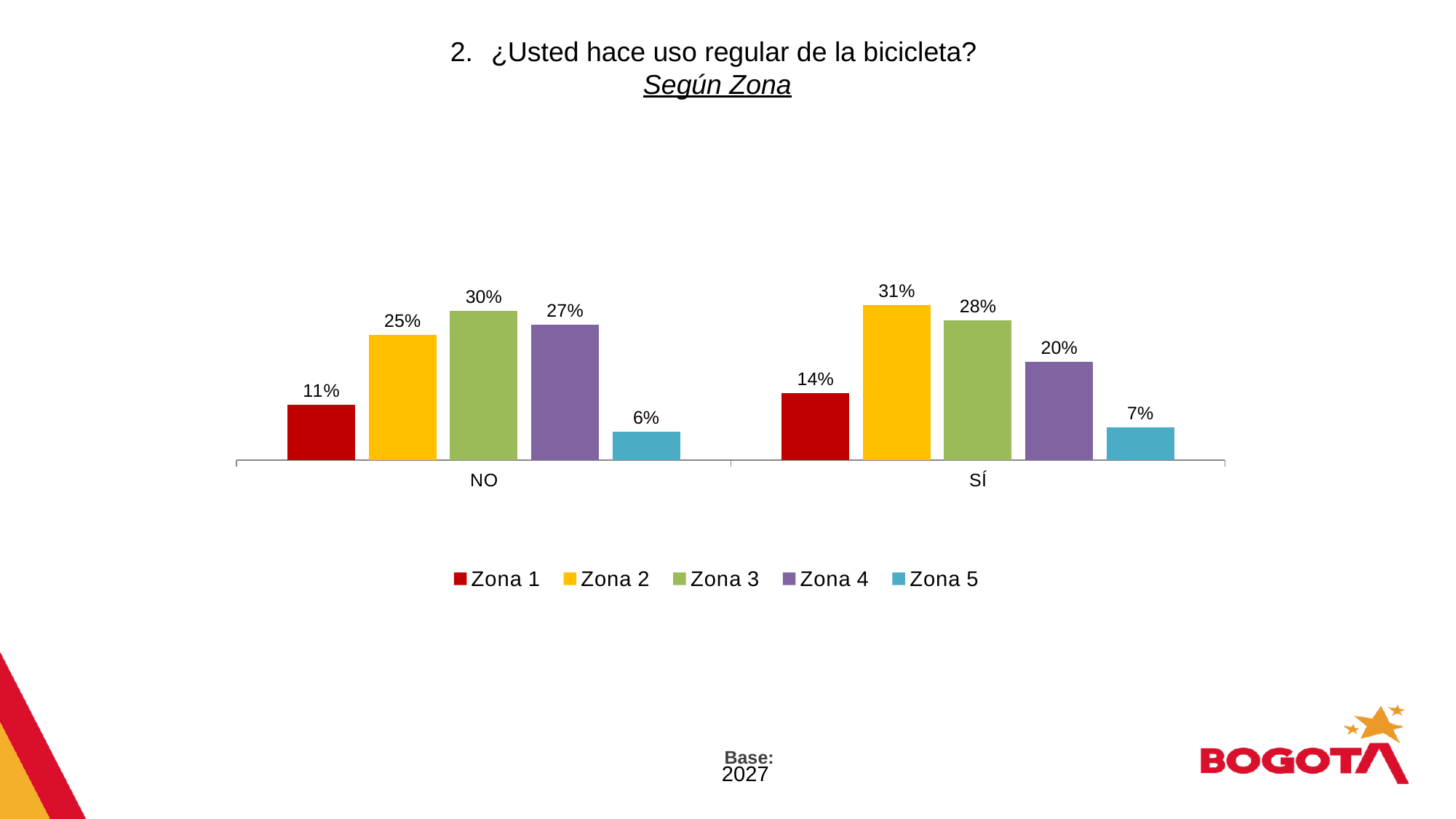
What is the value for Zona 1 in the SÍ category? 14% What is the value for Zona 3 in the NO category? 30% How many categories are shown on the x axis? 2 Which colour represents Zona 4 in the legend? Purple What kind of chart is shown on the slide? Bar chart Which is larger: Zona 2 in the NO category or Zona 2 in the SÍ category? Zona 2 in the SÍ category Which zone has the lowest value in the NO category? Zona 5 Which zone has the highest value in the SÍ category? Zona 2 How many series does the legend list? 5 What is the difference between Zona 3 and Zona 1 in the SÍ category? 14% What is the value for Zona 5 in the NO category? 6% What is the difference between Zona 4 in the NO category and Zona 4 in the SÍ category? 7%